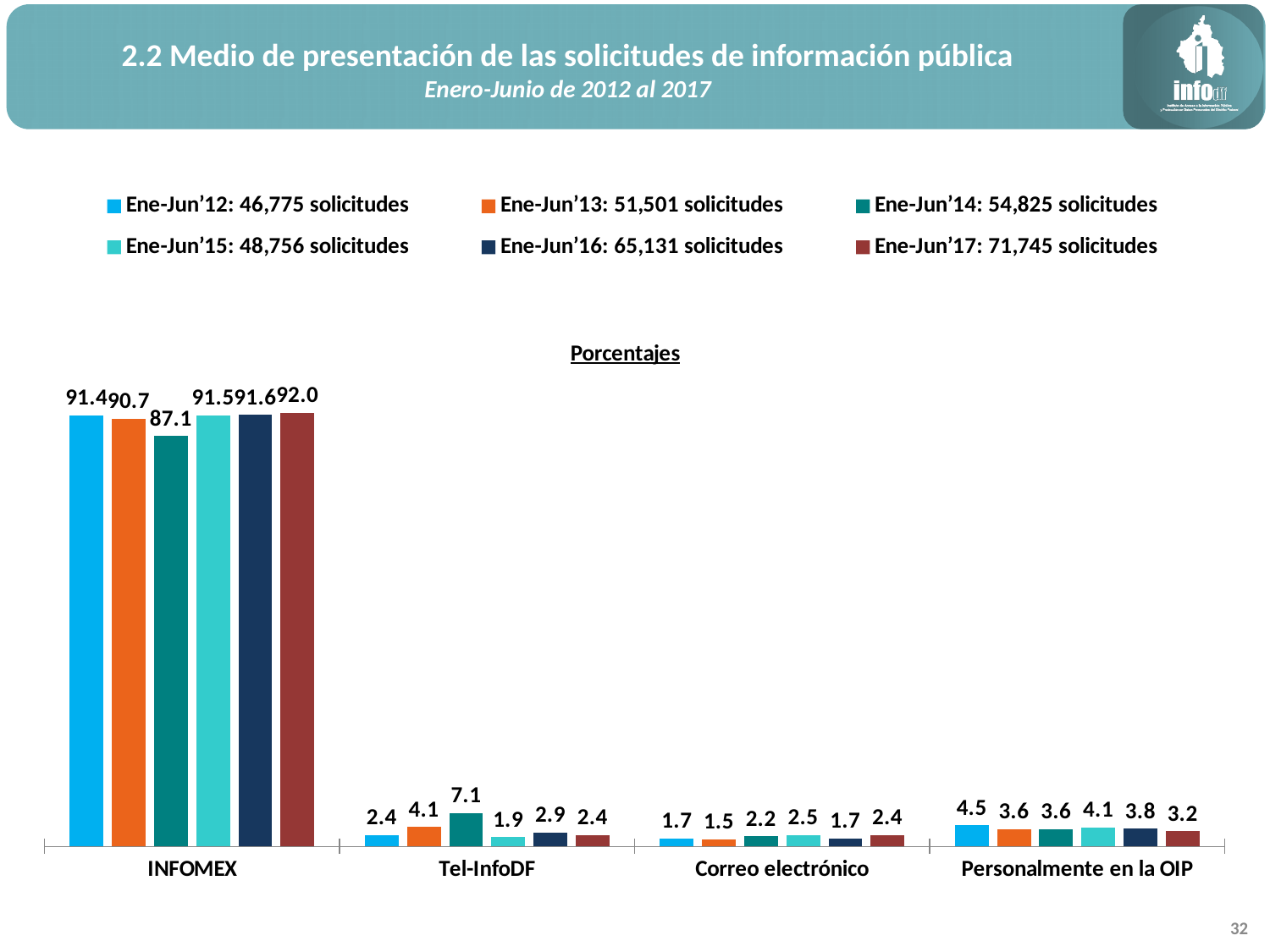
What is the value for Correo electrónico in the Ene-Jun'15 series? 2.5 What is the value for Tel-InfoDF in the Ene-Jun'14 series? 7.1 What kind of chart is shown on the slide? Bar chart Which category has the highest value in the Ene-Jun'17 series? INFOMEX What is the difference between the Ene-Jun'17 and Ene-Jun'14 values for INFOMEX? 4.9 What is the value for Personalmente en la OIP in the Ene-Jun'12 series? 4.5 What is the value for INFOMEX in the Ene-Jun'14 series? 87.1 Which series has the lowest value for INFOMEX? Ene-Jun'14 According to the legend, how many solicitudes were there in Ene-Jun'17? 71,745 How many categories are shown on the x axis? 4 Which is larger for Tel-InfoDF: the Ene-Jun'13 value or the Ene-Jun'16 value? Ene-Jun'13 How many series does the legend list? 6